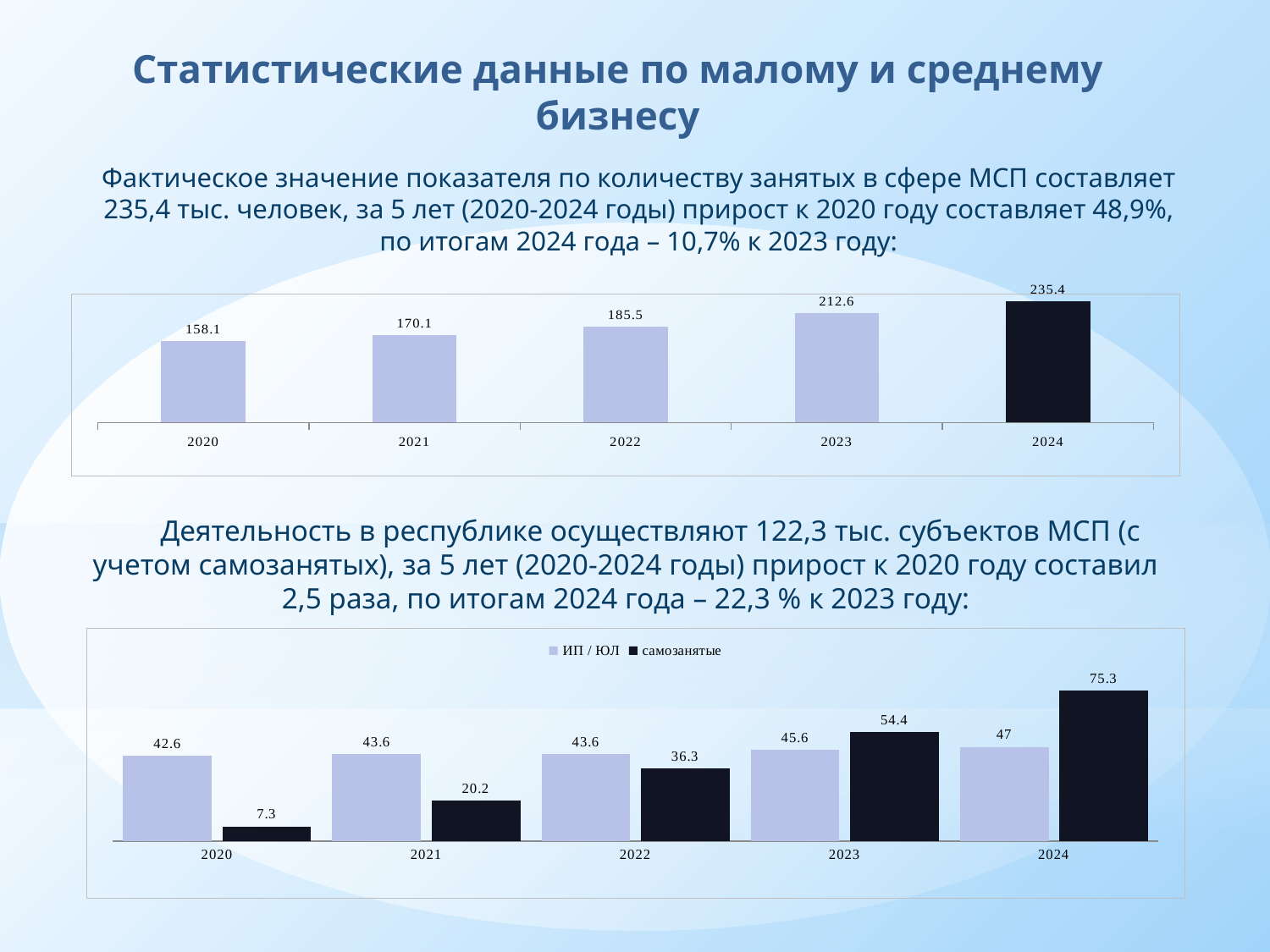
What type of chart is the bottom chart? bar chart In the top chart, do the values rise or fall from 2020 to 2024? rise In the top chart, which year has the lowest value? 2020 In the top chart, how many years are shown? 5 In the bottom chart, which is larger in 2023: ИП / ЮЛ or самозанятые? самозанятые In the top chart, which year has the highest value? 2024 In the bottom chart, what is the value for ИП / ЮЛ in 2024? 47 In the bottom chart, what is the difference between самозанятые and ИП / ЮЛ in 2024? 28.3 In the bottom chart, what is the value for самозанятые in 2021? 20.2 How many series does the legend of the bottom chart list? 2 In the top chart, what is the value for 2022? 185.5 In the top chart, what is the difference between the values for 2024 and 2023? 22.8